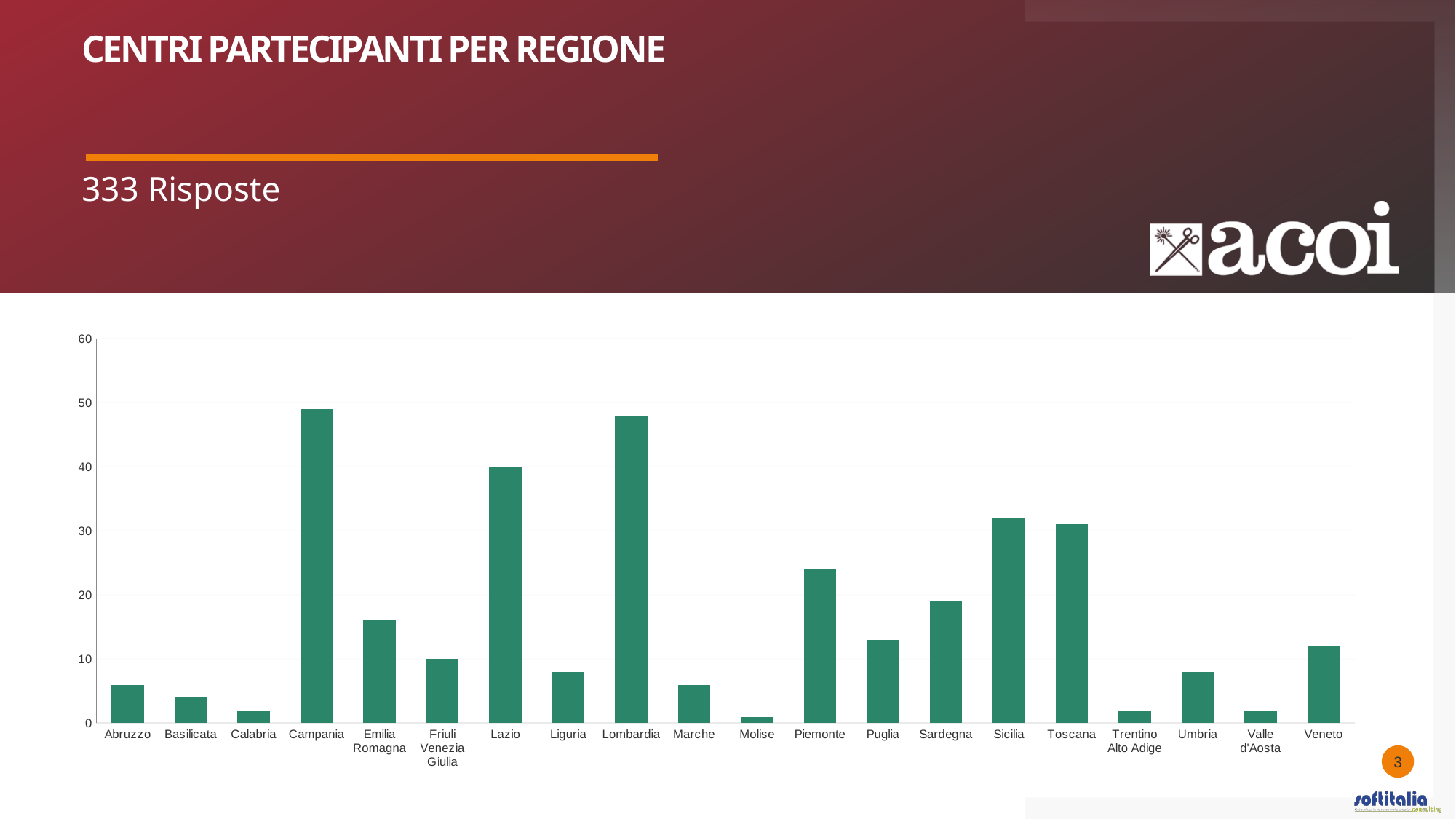
Is the value for Piemonte greater or less than 20? greater What is the title of the slide containing the chart? CENTRI PARTECIPANTI PER REGIONE Which region has the lowest bar in the chart? Molise Is the value for Emilia Romagna greater or less than 20? less Which has the larger value, Lazio or Sicilia? Lazio Is the value for Sicilia greater or less than 30? greater What kind of chart is shown on the slide? Bar chart Which has the larger value, Piemonte or Puglia? Piemonte How many regions are shown on the x axis of the chart? 20